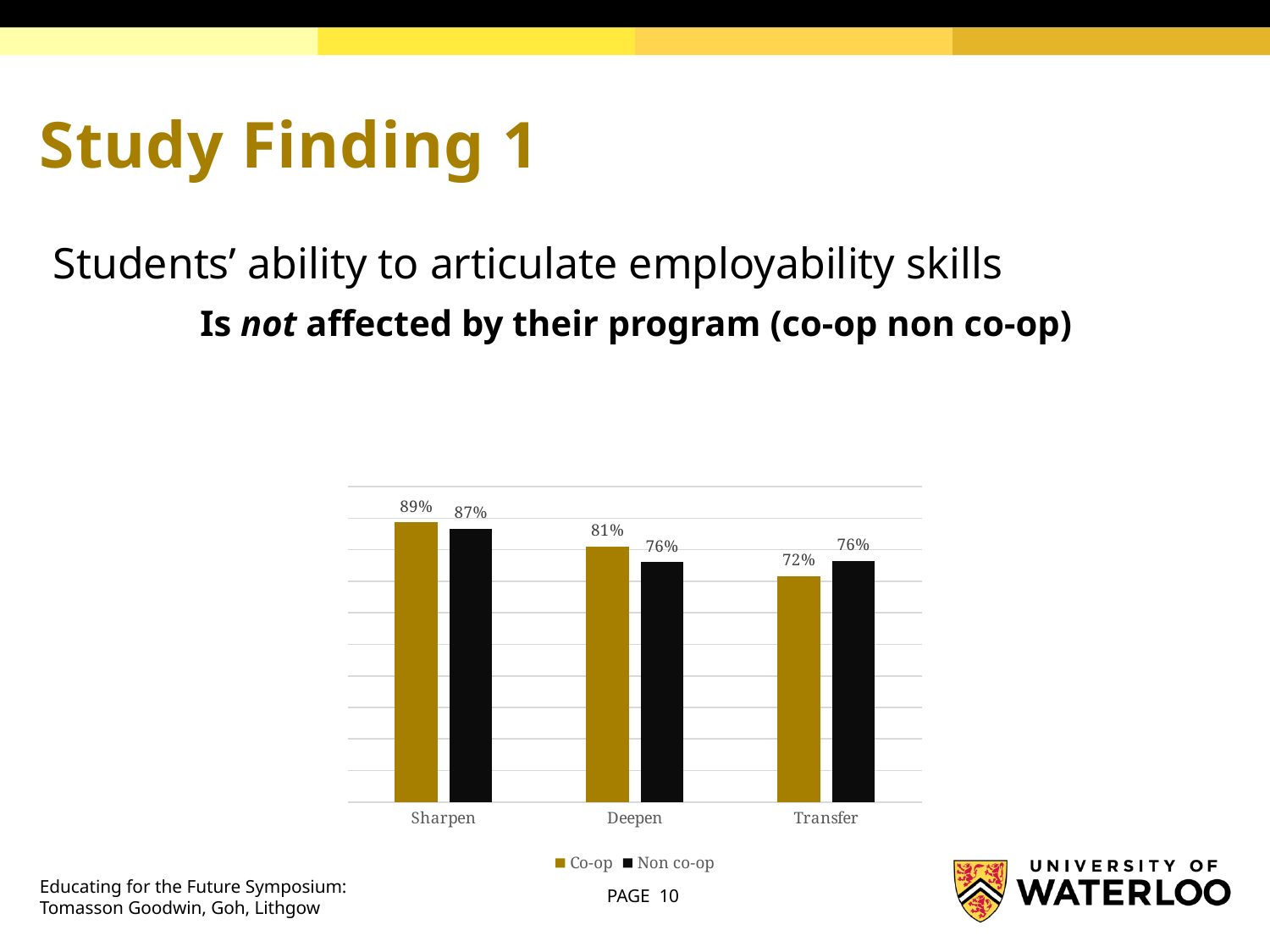
What is the difference between the Co-op and Non co-op values for Deepen? 5% What is the Co-op value for Sharpen? 89% What is the Non co-op value for Deepen? 76% What is the Co-op value for Transfer? 72% What is the Non co-op value for Sharpen? 87% Which colour represents the Co-op series in the legend? Gold Which is larger for Transfer, the Co-op value or the Non co-op value? Non co-op What kind of chart is shown on the slide? Bar chart How many categories are shown on the x axis? 3 Which category has the highest Co-op value? Sharpen Which category has the lowest Co-op value? Transfer How many series does the legend list? 2